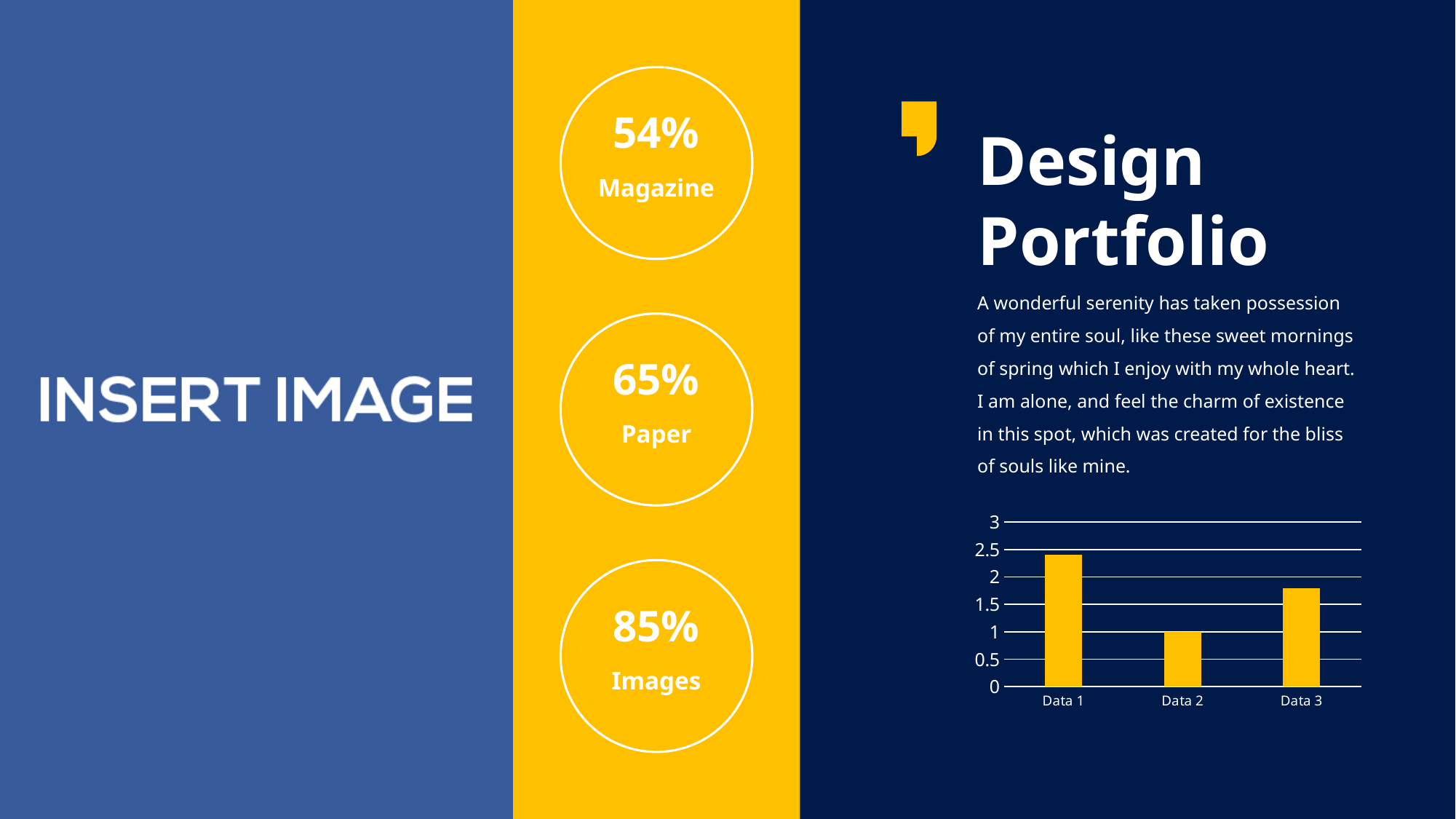
How many categories are plotted on the bar chart? 3 Is the value for Data 3 greater or less than 2? less Which is larger on the bar chart, Data 2 or Data 3? Data 3 Which is larger on the bar chart, Data 1 or Data 3? Data 1 Is the value for Data 1 greater or less than 2? greater What is the value for Data 2 on the bar chart? 1 Which category has the highest value on the bar chart? Data 1 What colour are the bars in the chart? yellow What kind of chart is shown on the slide? bar chart Which category has the lowest value on the bar chart? Data 2 What is the highest value shown on the vertical axis of the bar chart? 3 Is the value for Data 3 greater or less than 1.5? greater